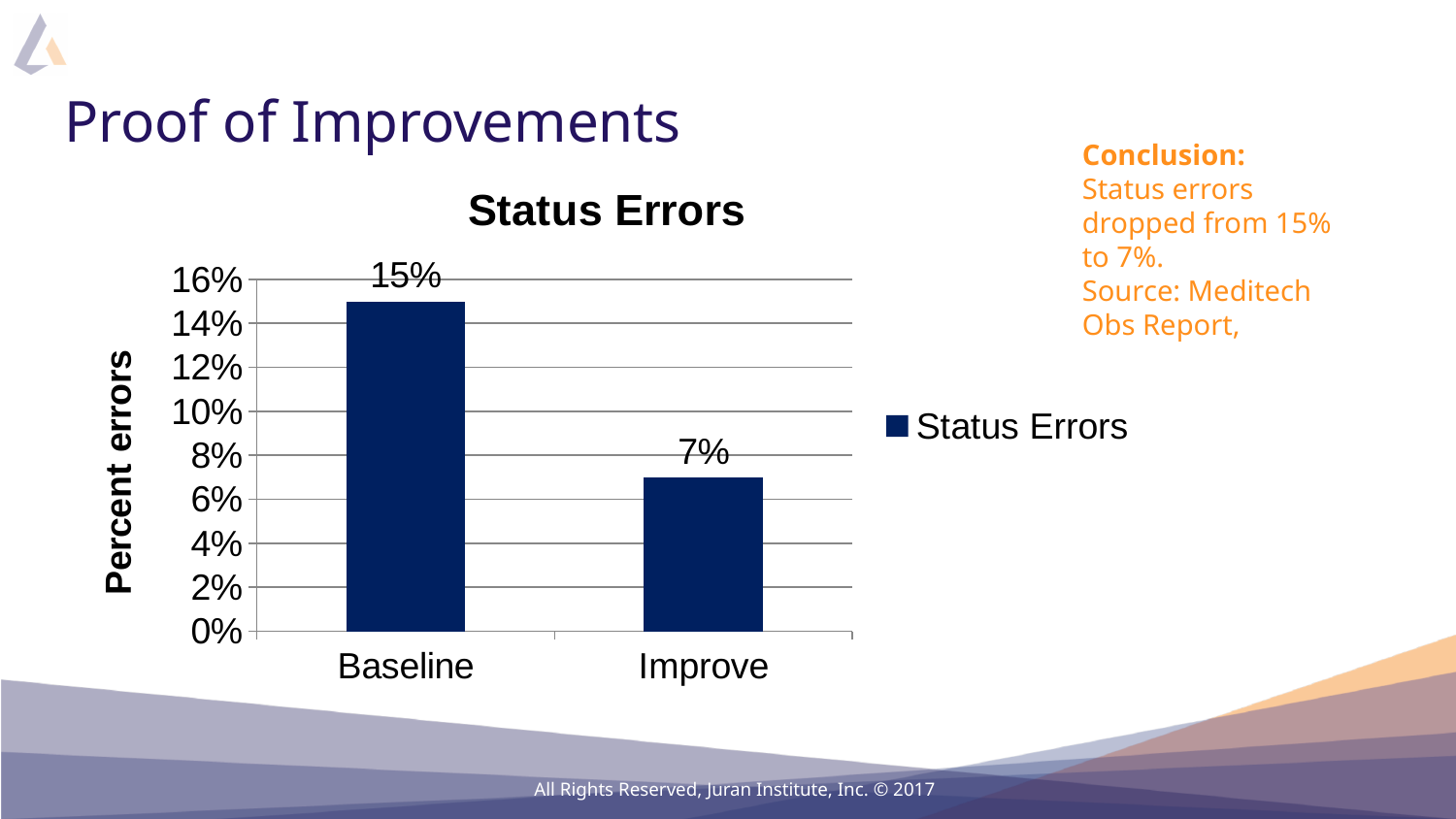
What kind of chart is the Status Errors chart? bar chart What is the value for Baseline in the Status Errors chart? 15% Which category has the lowest value in the Status Errors chart? Improve What is the value for Improve in the Status Errors chart? 7% Which is larger in the Status Errors chart, Baseline or Improve? Baseline Is the value for Improve greater or less than 10% in the Status Errors chart? less Which category has the highest value in the Status Errors chart? Baseline Do the values rise or fall from Baseline to Improve in the Status Errors chart? fall How many categories are shown on the x axis of the Status Errors chart? 2 How many series does the legend of the Status Errors chart list? 1 What is the label on the y axis of the Status Errors chart? Percent errors What is the difference between the Baseline and Improve values in the Status Errors chart? 8%